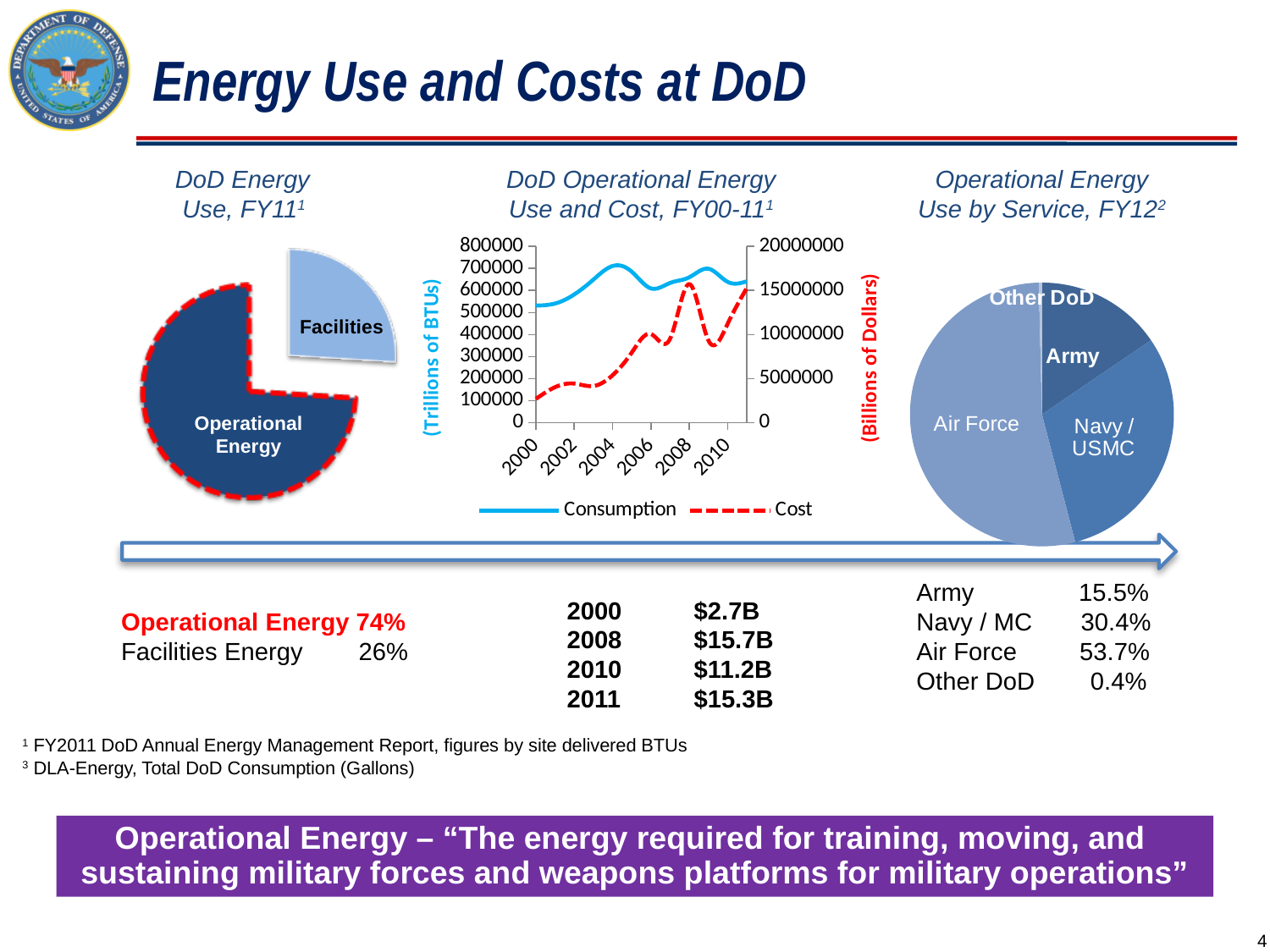
In the 'Operational Energy Use by Service, FY12' pie chart, what is the share for Navy / MC? 30.4% How many series does the legend of the 'DoD Operational Energy Use and Cost, FY00-11' chart list? 2 In the 'DoD Operational Energy Use and Cost, FY00-11' chart, does the Cost series generally rise or fall from 2000 to 2011? Rise In the 'DoD Operational Energy Use and Cost, FY00-11' chart, how much higher was the cost in 2011 than in 2010? $4.1B In the 'DoD Energy Use, FY11' pie chart, what share of energy use is Operational Energy? 74% In the 'Operational Energy Use by Service, FY12' pie chart, how many slices are there? 4 In the 'DoD Energy Use, FY11' pie chart, which slice is larger, Operational Energy or Facilities? Operational Energy In the 'Operational Energy Use by Service, FY12' pie chart, which service has the largest share? Air Force In the 'DoD Operational Energy Use and Cost, FY00-11' chart, what was the cost in 2008? $15.7B What kind of chart is the 'DoD Operational Energy Use and Cost, FY00-11' chart? Line chart In the 'DoD Energy Use, FY11' pie chart, what share of energy use is Facilities Energy? 26% In the 'DoD Operational Energy Use and Cost, FY00-11' chart, what was the cost in 2000? $2.7B